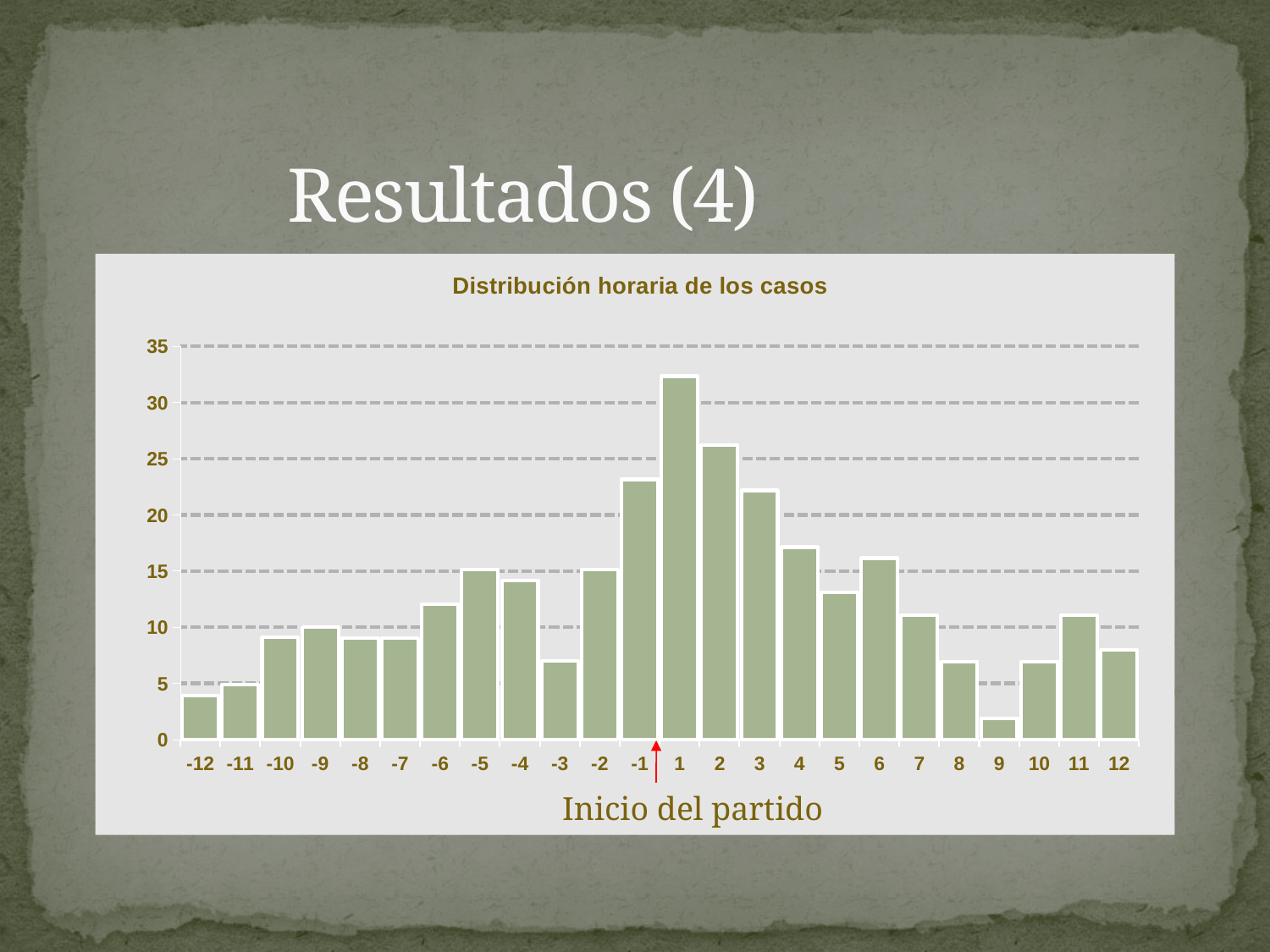
Which is larger, the value for category -6 or the value for category -3? -6 Is the value for category 1 greater or less than 30? greater Is the value for category -3 greater or less than 10? less Is the value for category 9 greater or less than 5? less What kind of chart is shown on the slide? bar chart Which category has the highest bar in the chart? 1 Which is larger, the value for category 1 or the value for category 2? 1 What is the title of the chart? Distribución horaria de los casos Which category has the lowest bar in the chart? 9 What label is written below the x axis next to the red arrow? Inicio del partido How many categories are shown on the x axis of the chart? 24